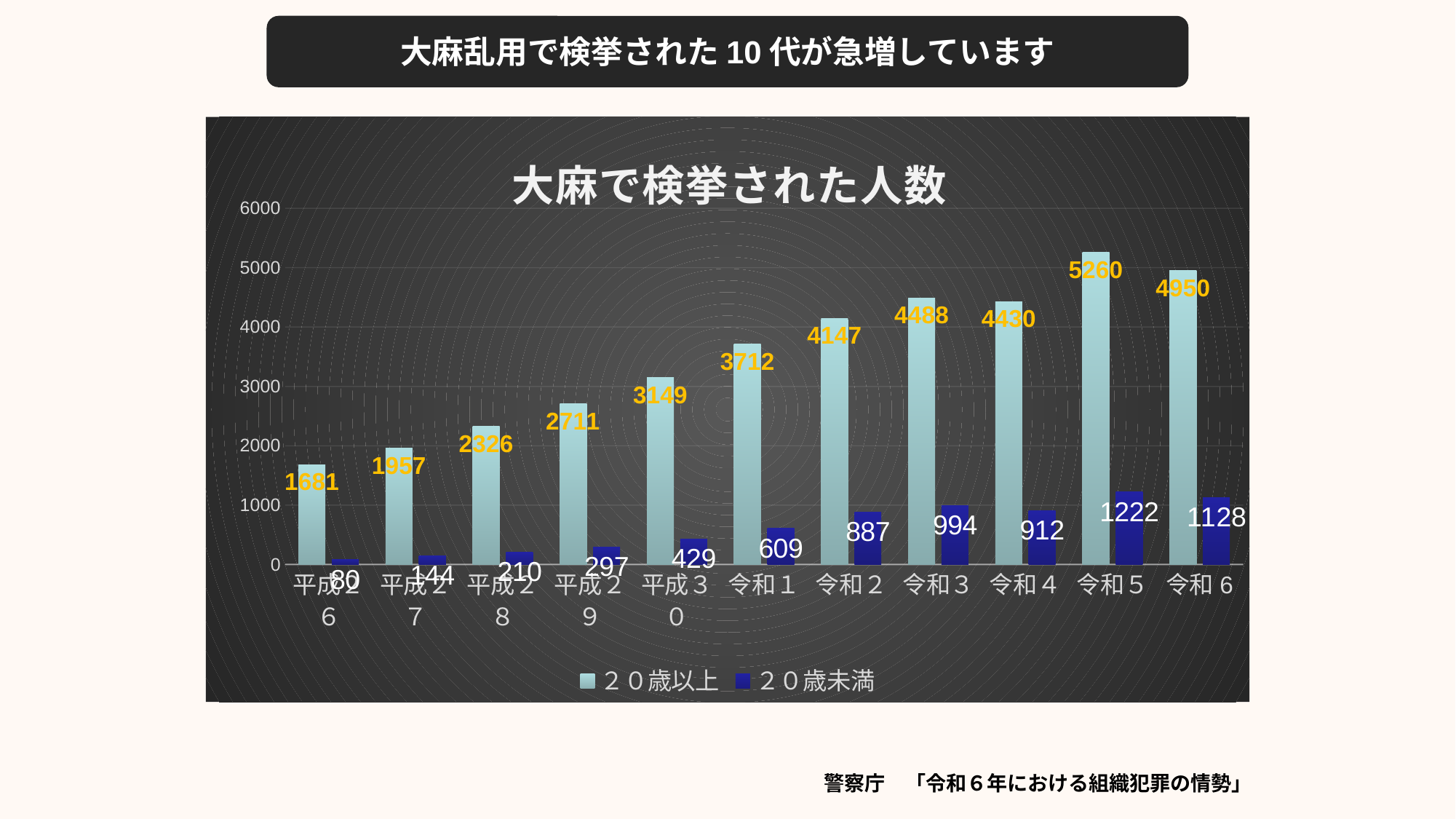
Does the 20歳未満 series generally rise or fall from 平成26 to 令和５? rise What is the title of the chart? 大麻で検挙された人数 What type of chart is shown on the slide? bar chart Which year has the highest value for 20歳未満? 令和５ Which is larger, the 20歳未満 value for 令和３ or for 令和４? 令和３ What is the value for 20歳未満 in 平成26? 80 What is the value for 20歳以上 in 令和５? 5260 What is the value for 20歳未満 in 令和６? 1128 Which year has the lowest value for 20歳以上? 平成26 How many series does the legend list? 2 What is the difference between the 20歳以上 values for 令和５ and 令和６? 310 How many year categories are shown on the x axis? 11